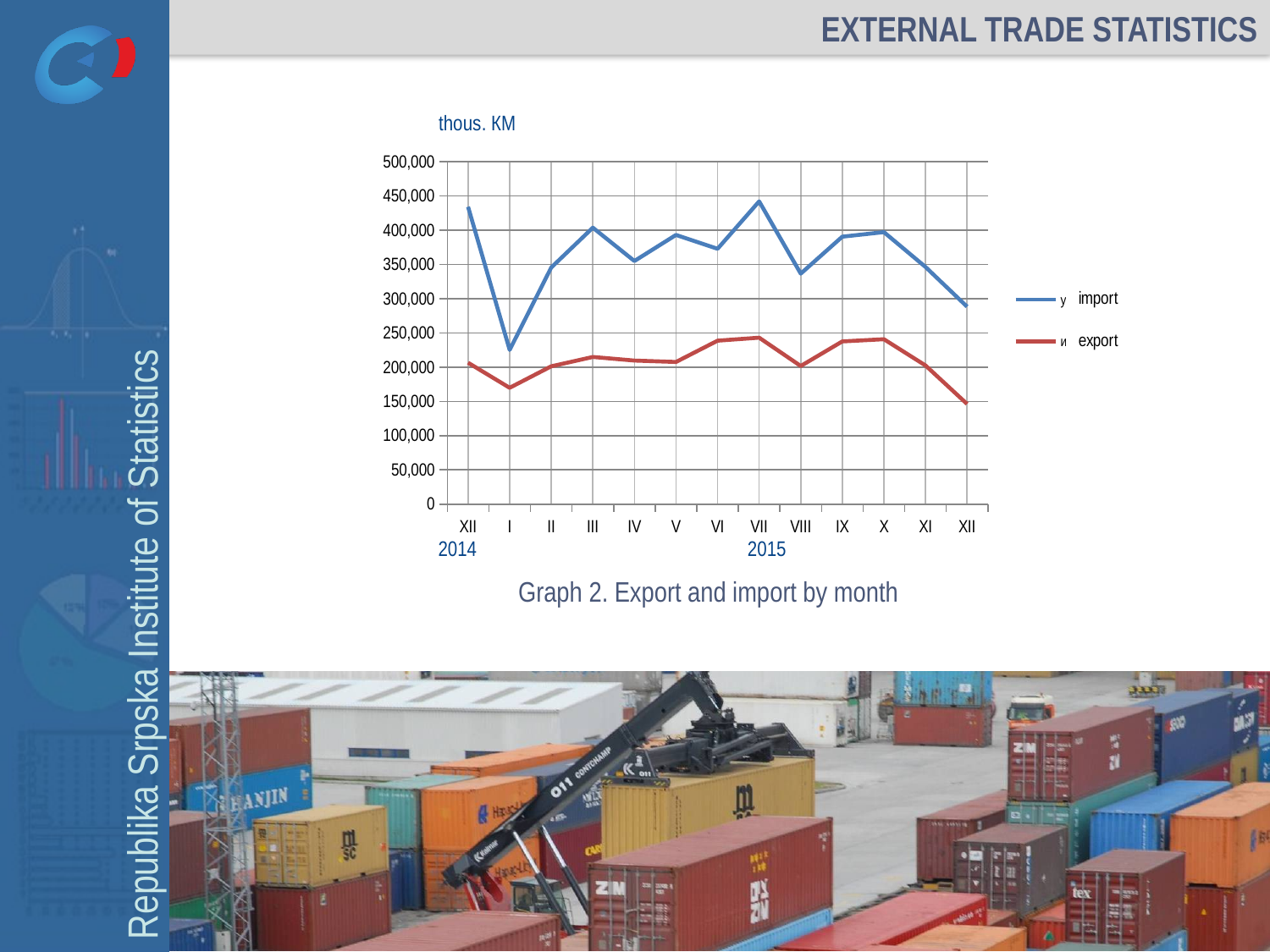
How many monthly points are plotted along the x axis? 13 What unit is shown above the y axis of the chart? thous. KM Is the import value for month I 2015 greater or less than 250,000? less In which month is the export value lowest? XII (2015) How many series does the legend list? 2 Is the export value for month XII 2015 greater or less than 200,000? less In which month is the import value lowest? I (2015) Is the import value for month VII 2015 greater or less than 400,000? greater What kind of chart is shown on the slide? line chart Which is larger, the import value for XII 2014 or the import value for XII 2015? XII 2014 Which is larger in month VII 2015, import or export? import